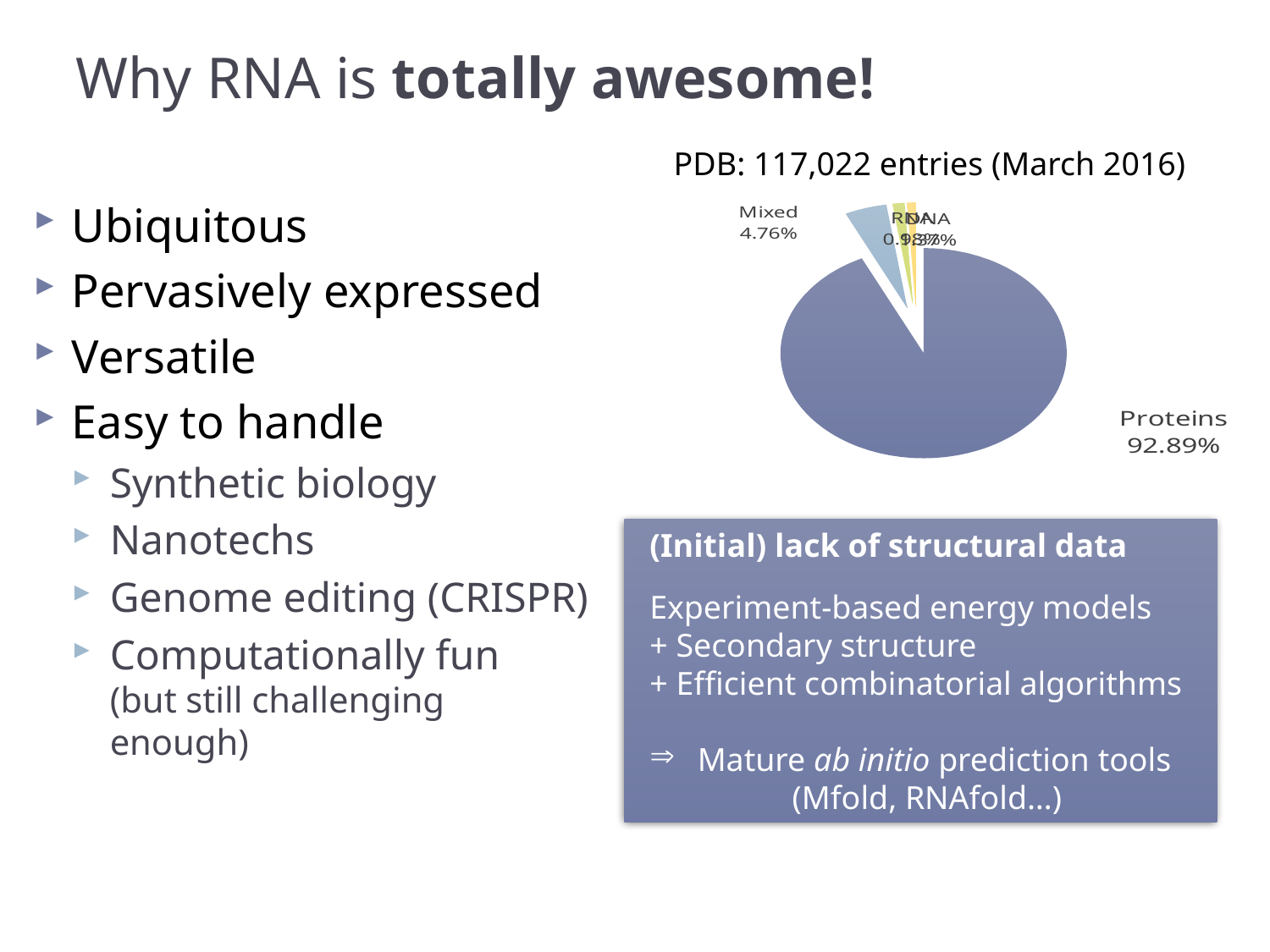
Which category has the largest slice of the pie chart? Proteins What percentage of the pie chart is labelled Mixed? 4.76% What percentage of the pie chart is labelled Proteins? 92.89% What kind of chart is shown on the slide? pie chart Which slice is larger, Proteins or Mixed? Proteins How many slices does the pie chart have? 4 What share of the pie does the Mixed slice represent? 4.76% What is the title of the pie chart? PDB: 117,022 entries (March 2016) What is the difference in percentage points between the Proteins slice and the Mixed slice? 88.13%